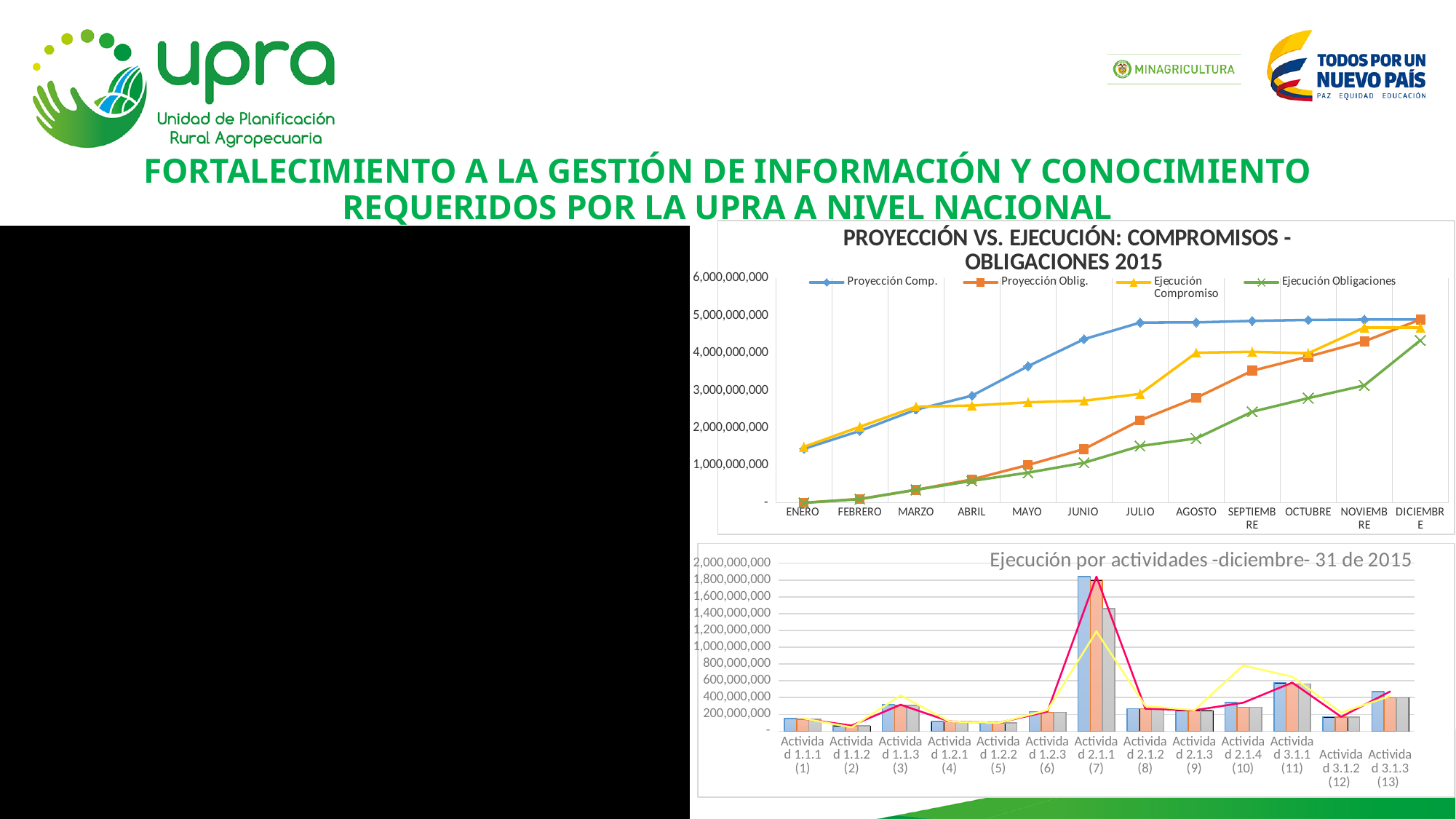
In the top chart 'PROYECCIÓN VS. EJECUCIÓN: COMPROMISOS - OBLIGACIONES 2015', how many series does the legend list? 4 In the top chart, which is larger in AGOSTO: Ejecución Compromiso or Proyección Oblig.? Ejecución Compromiso In the top chart 'PROYECCIÓN VS. EJECUCIÓN: COMPROMISOS - OBLIGACIONES 2015', how many months are shown on the x axis? 12 In the top chart, does the Proyección Comp. series rise or fall from ENERO to DICIEMBRE? Rise In the top chart, is the value of Ejecución Obligaciones in JUNIO greater or less than 2,000,000,000? less In the bottom chart 'Ejecución por actividades -diciembre- 31 de 2015', how many activity categories are shown on the x axis? 13 In the top chart, is the value of Proyección Comp. in JULIO greater or less than 4,000,000,000? greater In the top chart, in which month is the Ejecución Obligaciones series lowest? ENERO In the bottom chart, is the tallest bar for Actividad 2.1.1 (7) greater or less than 1,600,000,000? greater What kind of chart is the top chart 'PROYECCIÓN VS. EJECUCIÓN: COMPROMISOS - OBLIGACIONES 2015'? Line chart In the bottom chart 'Ejecución por actividades -diciembre- 31 de 2015', which activity has the highest bars? Actividad 2.1.1 (7) In the top chart, which series is marked with green X markers in the legend? Ejecución Obligaciones